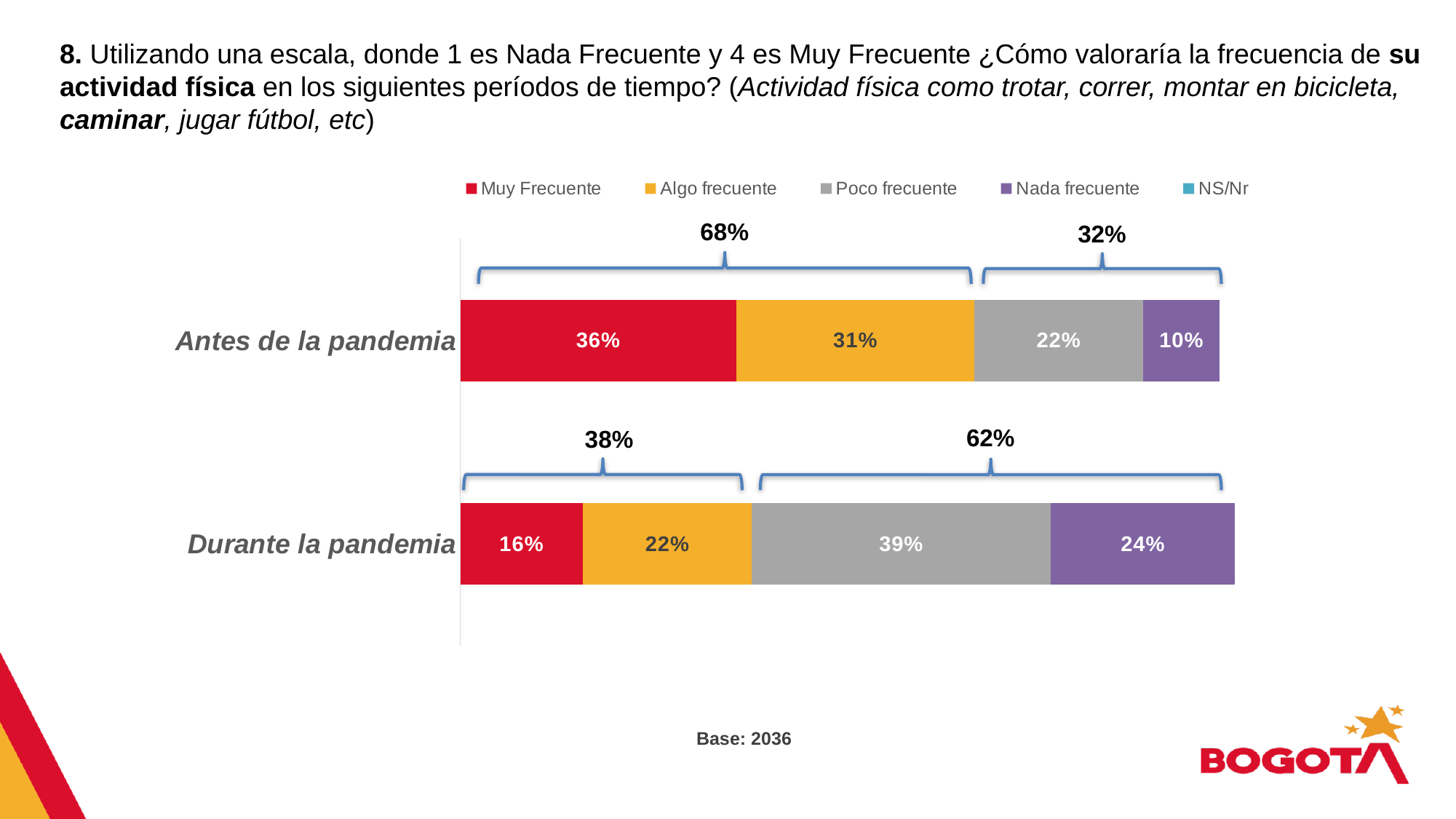
What kind of chart is shown on the slide? Stacked bar chart How many series does the legend list? 5 Which series has the smallest segment in the Antes de la pandemia bar? Nada frecuente What is the combined share of Muy Frecuente and Algo frecuente for Antes de la pandemia, as shown by the bracket label? 68% What is the difference between the Muy Frecuente values for Antes de la pandemia and Durante la pandemia? 20% Which series has the largest segment in the Durante la pandemia bar? Poco frecuente How many categories (bars) are shown in the chart? 2 What is the value for Nada frecuente in the Antes de la pandemia bar? 10% What is the value for Algo frecuente in the Durante la pandemia bar? 22% Which is larger: Nada frecuente for Antes de la pandemia or Nada frecuente for Durante la pandemia? Durante la pandemia What is the value for Poco frecuente in the Durante la pandemia bar? 39% What is the value for Muy Frecuente in the Antes de la pandemia bar? 36%